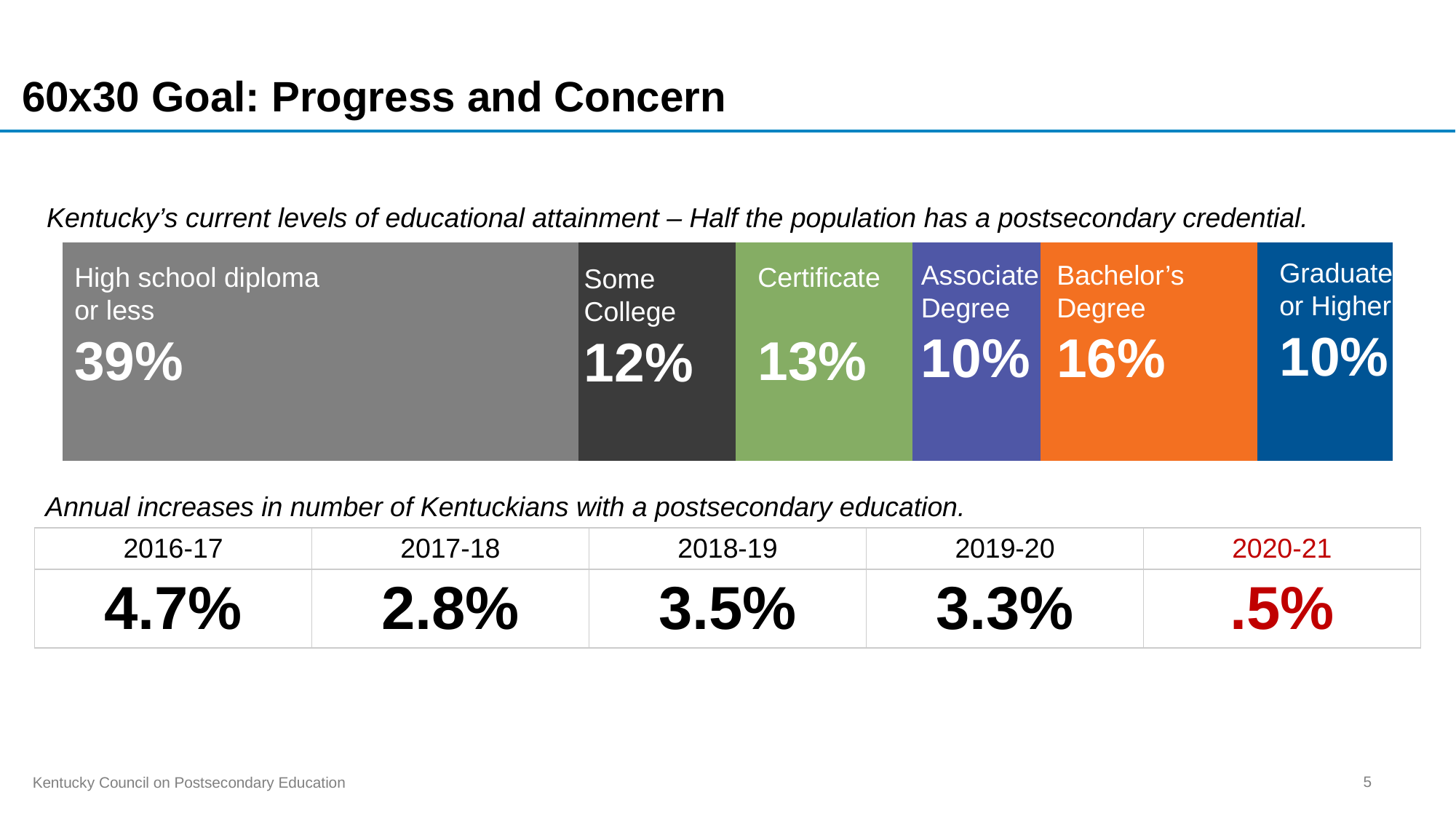
In the educational attainment bar chart, which category has the largest share? High school diploma or less In the educational attainment bar chart, what is the value for Bachelor's Degree? 16% In the educational attainment bar chart, what percentage of Kentuckians have a high school diploma or less? 39% In the table of annual increases in Kentuckians with a postsecondary education, which year has the lowest increase? 2020-21 In the educational attainment bar chart, what colour is the Bachelor's Degree segment? Orange In the educational attainment bar chart, which is larger: Certificate or Some College? Certificate In the educational attainment bar chart, what do all six segments add up to? 100% In the educational attainment bar chart, what is the value for Certificate? 13% How many categories are shown in the educational attainment bar chart? 6 What kind of chart shows Kentucky's current levels of educational attainment? Stacked bar chart In the educational attainment bar chart, what is the difference between Bachelor's Degree and Certificate? 3% In the educational attainment bar chart, what is the value for Some College? 12%